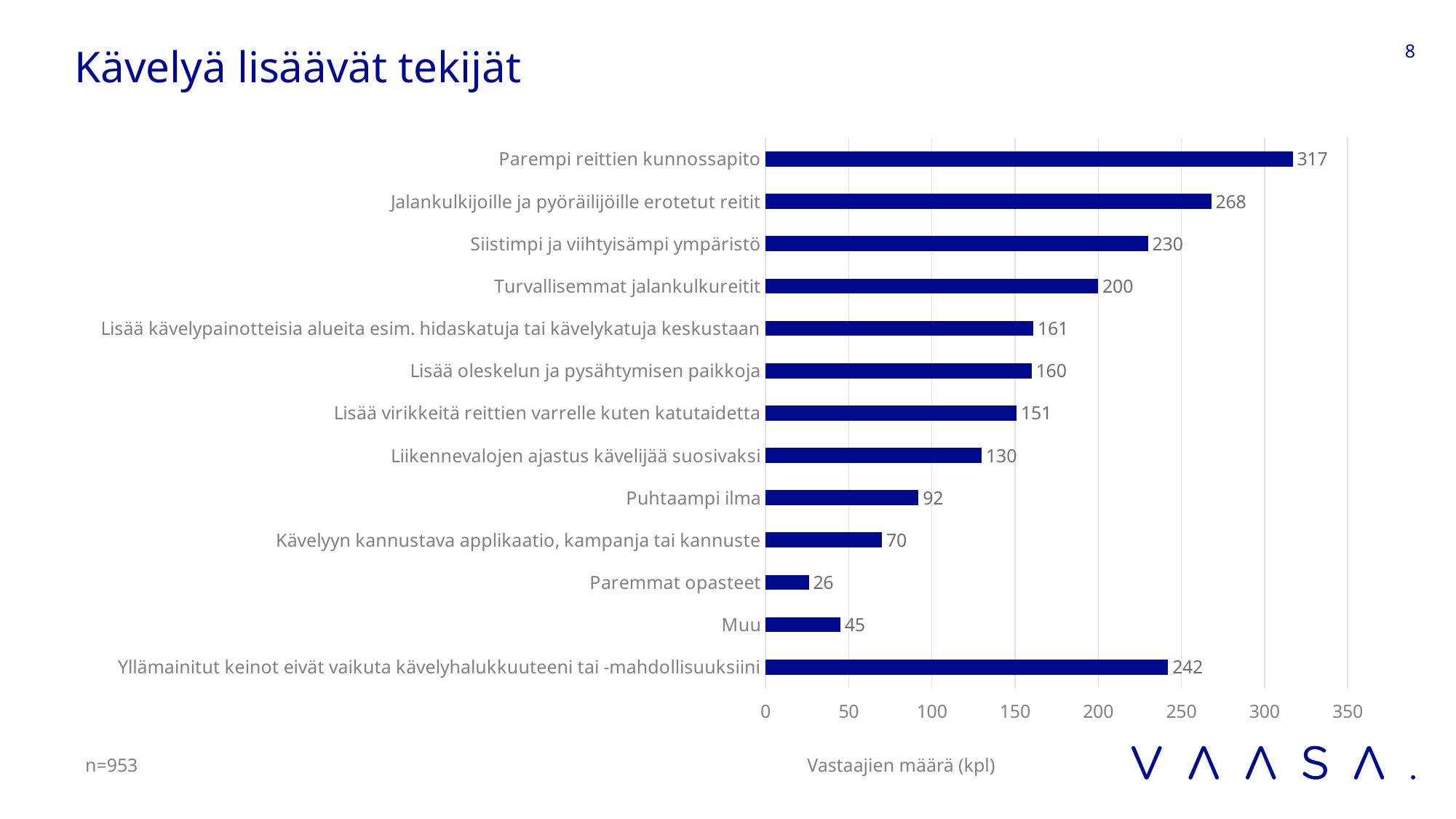
Which category has the highest value? Parempi reittien kunnossapito Which category has the lowest value? Paremmat opasteet What is the title of the slide? Kävelyä lisäävät tekijät What is the value for "Yllämainitut keinot eivät vaikuta kävelyhalukkuuteeni tai -mahdollisuuksiini"? 242 Is the value for "Liikennevalojen ajastus kävelijää suosivaksi" greater or less than 150? less What is the value for "Parempi reittien kunnossapito"? 317 What is the value for "Puhtaampi ilma"? 92 What kind of chart is shown on the slide? Bar chart What is the x-axis label of the chart? Vastaajien määrä (kpl) Which is larger, "Muu" or "Paremmat opasteet"? Muu How many categories are shown in the chart? 13 What is the difference between "Jalankulkijoille ja pyöräilijöille erotetut reitit" and "Siistimpi ja viihtyisämpi ympäristö"? 38